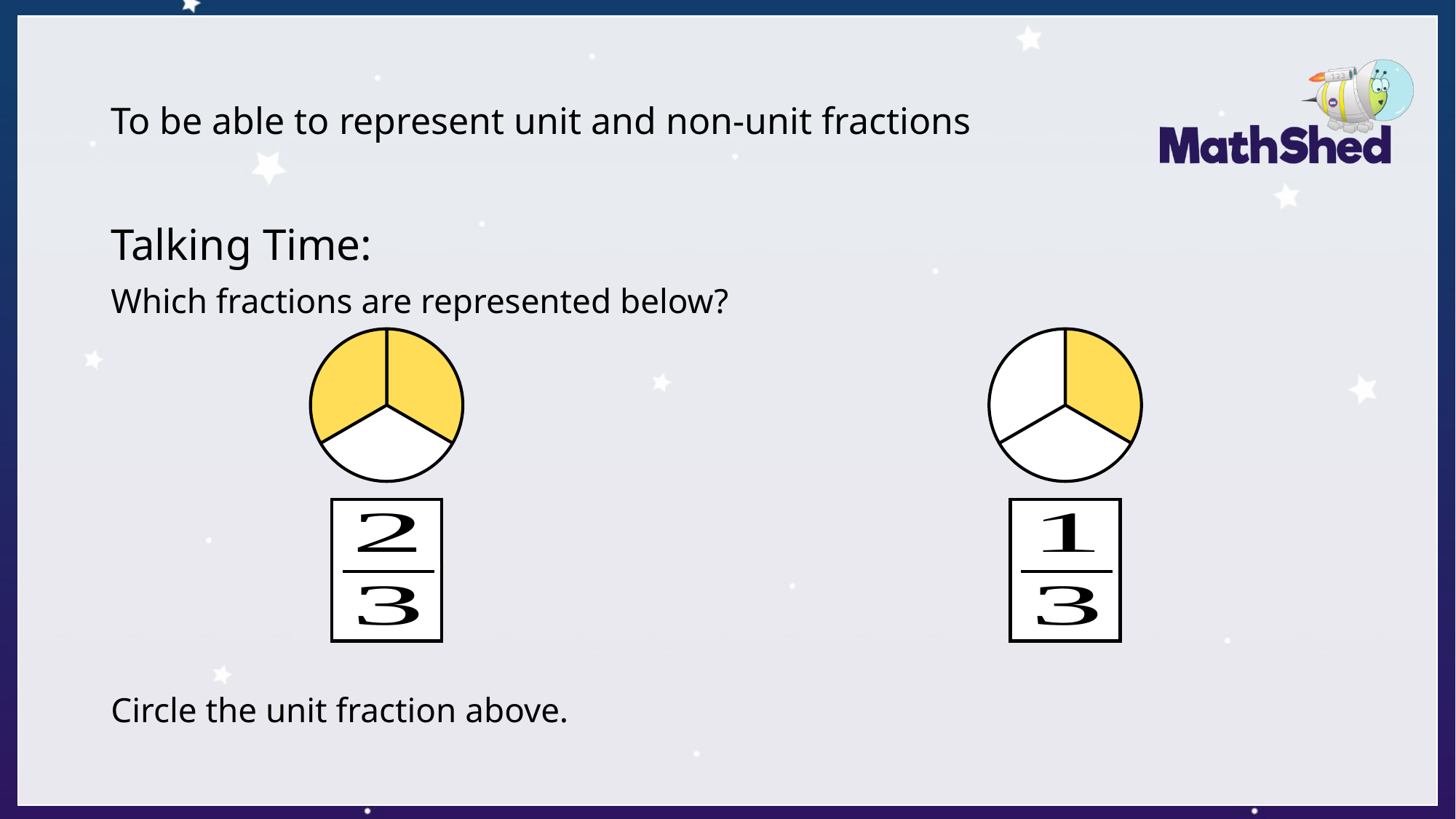
Which of the two fractions shown is the unit fraction? 1/3 In the left circle, how many parts are unshaded? 1 Which circle has the larger shaded portion, the left or the right? left What colour are the shaded parts of the circles? yellow In the left circle, how many parts are shaded? 2 In the right circle, how many parts are shaded? 1 What fraction of the right circle is shaded? 1/3 What fraction of the left circle is shaded? 2/3 What kind of chart is used to represent the fractions on the slide? pie chart